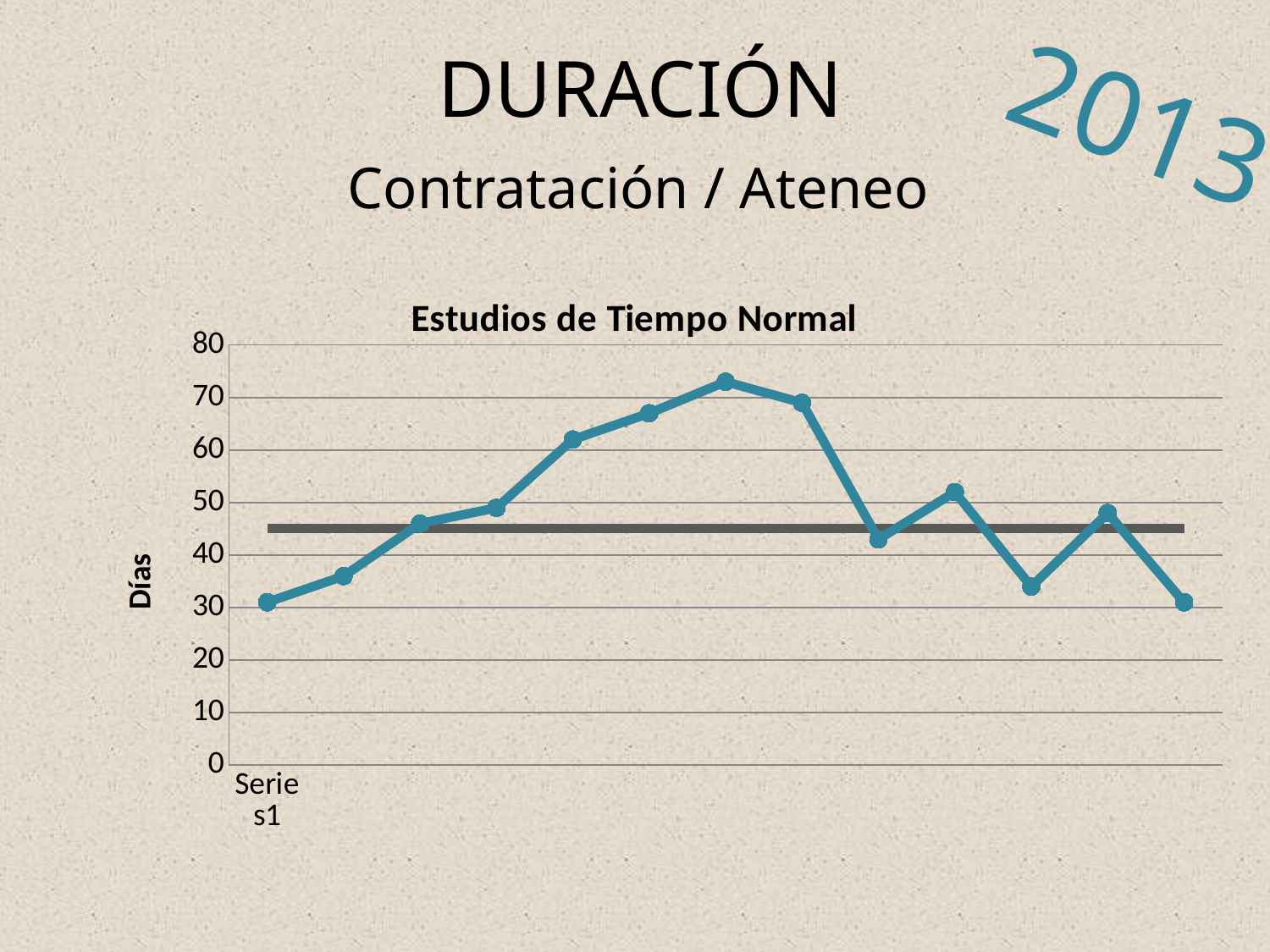
What is the label on the vertical axis of the chart? Días What is the title of the chart? Estudios de Tiempo Normal How many data points are plotted on the line? 13 What is the maximum value shown on the vertical axis? 80 Is the value of the ninth data point on the line greater or less than 50? less Is the value of the last data point on the line greater or less than 40? less What kind of chart is shown on the slide? line chart Which data point on the line has the highest value, counting from the left? the seventh Is the value of the highest data point on the line greater or less than 70? greater Do the values rise or fall from the first data point to the seventh data point? rise